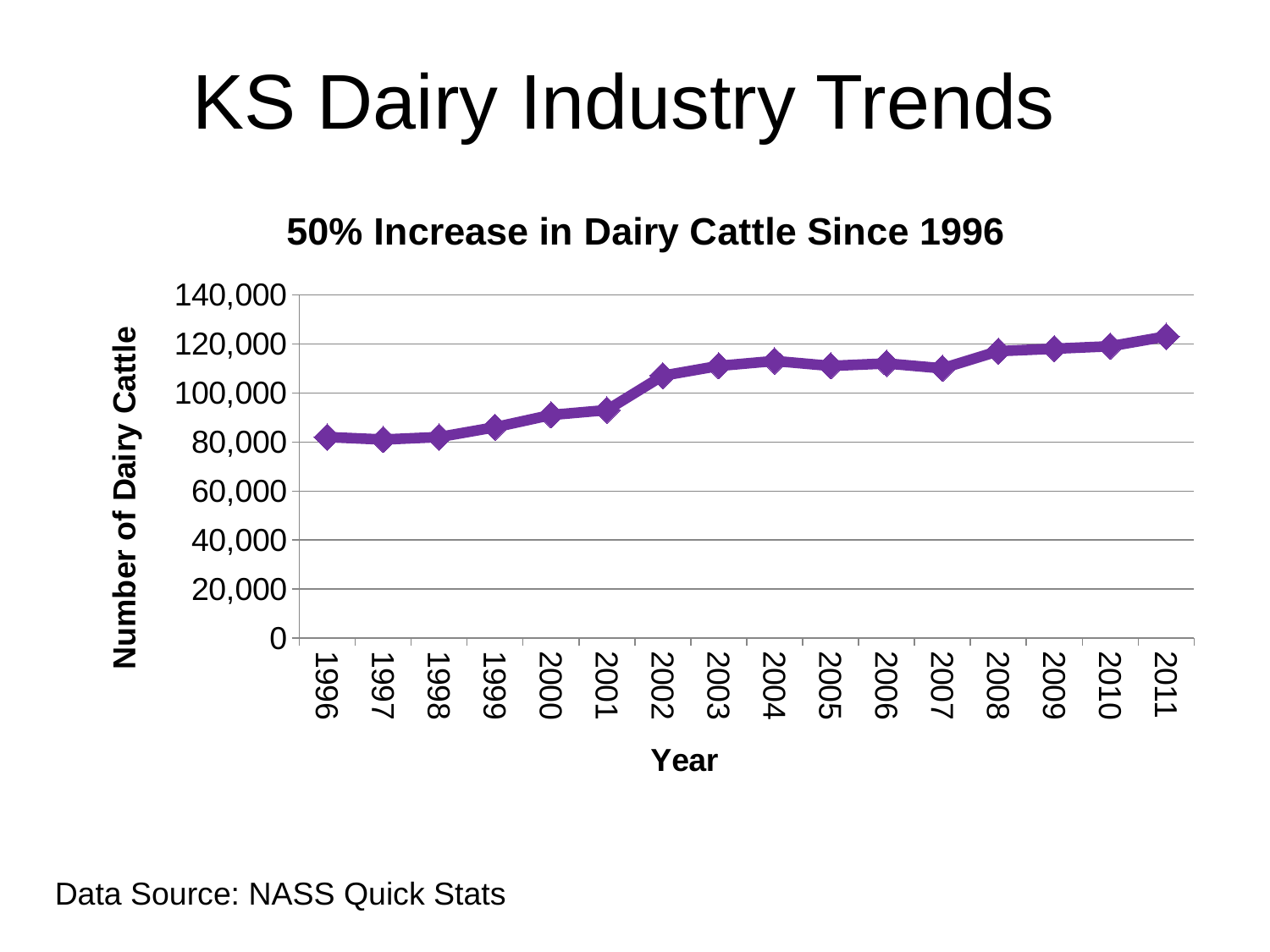
Is the value for 2001 greater or less than 100,000? less Is the value for 2002 greater or less than 100,000? greater What kind of chart is shown on the slide? Line chart Is the value for 2011 greater or less than 120,000? greater Overall, do the values rise or fall from 1996 to 2011? Rise Which year has the larger number of dairy cattle, 2001 or 2002? 2002 What is the label on the vertical axis of the chart? Number of Dairy Cattle What is the title of the chart? 50% Increase in Dairy Cattle Since 1996 Which year has the larger number of dairy cattle, 1996 or 2011? 2011 Which year has the highest number of dairy cattle? 2011 How many years are plotted on the x axis of the chart? 16